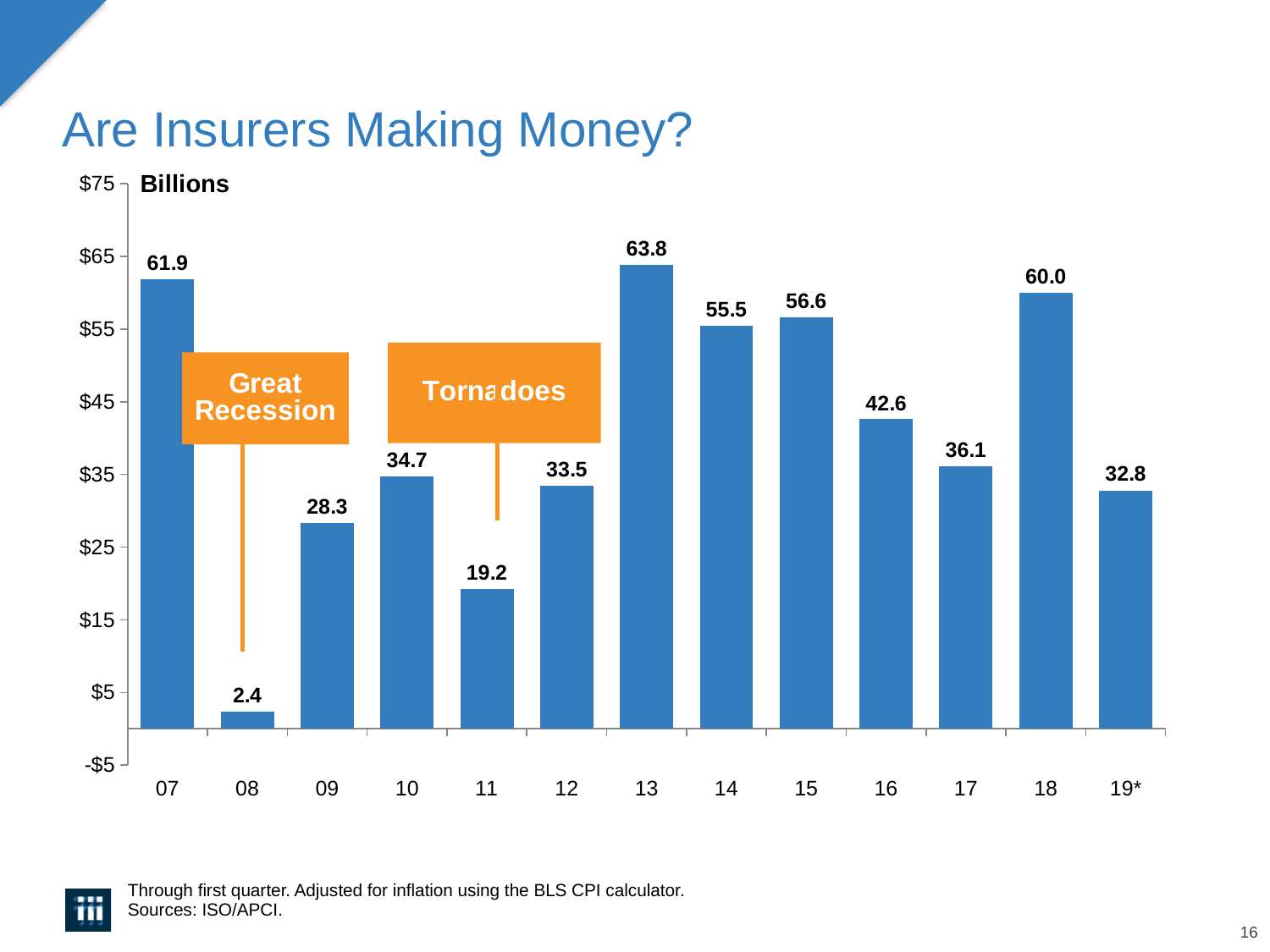
Do the values rise or fall from 08 to 10? rise What is the value for 19*? 32.8 What is the value for 07? 61.9 What is the difference between the values for 13 and 18? 3.8 Which year has the highest value? 13 Which year has the lowest value? 08 What is the title of the slide? Are Insurers Making Money? Which is larger, the value for 14 or the value for 15? 15 What kind of chart is this? bar chart Is the value for 16 greater or less than $45? less What is the value for 11? 19.2 How many years are shown on the x axis? 13